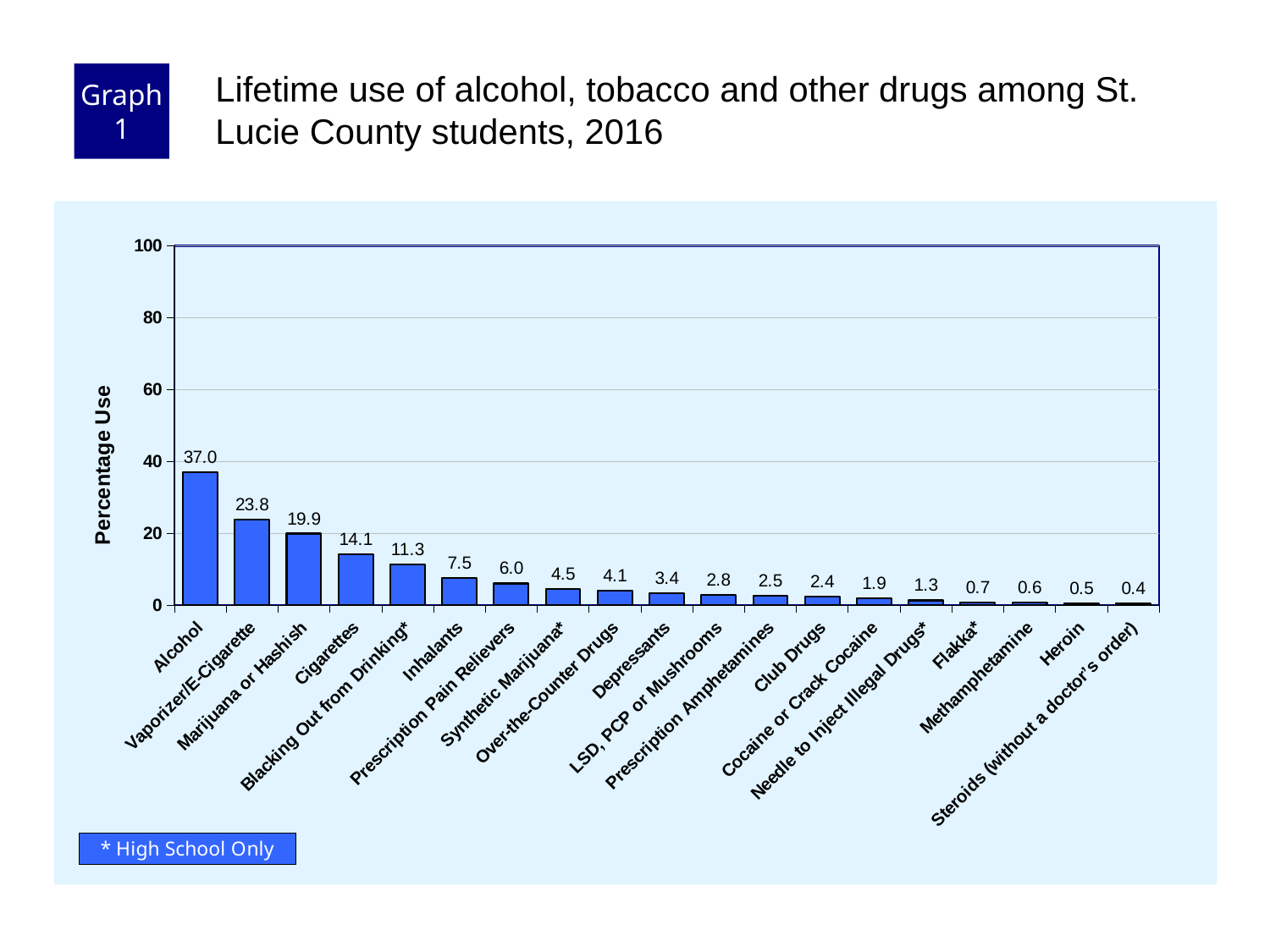
Is the value for Vaporizer/E-Cigarette greater or less than 20? greater What kind of chart is shown on the slide? Bar chart What is the difference in percentage use between Alcohol and Vaporizer/E-Cigarette? 13.2 What is the percentage use for Cigarettes? 14.1 Which has a higher percentage use, Marijuana or Hashish or Cigarettes? Marijuana or Hashish How many categories are shown on the chart? 19 Which category has the lowest percentage use? Steroids (without a doctor's order) Which category has the highest percentage use? Alcohol What is the percentage use for Alcohol? 37.0 What is the percentage use for Inhalants? 7.5 What is the label of the y axis? Percentage Use What is the percentage use for Heroin? 0.5